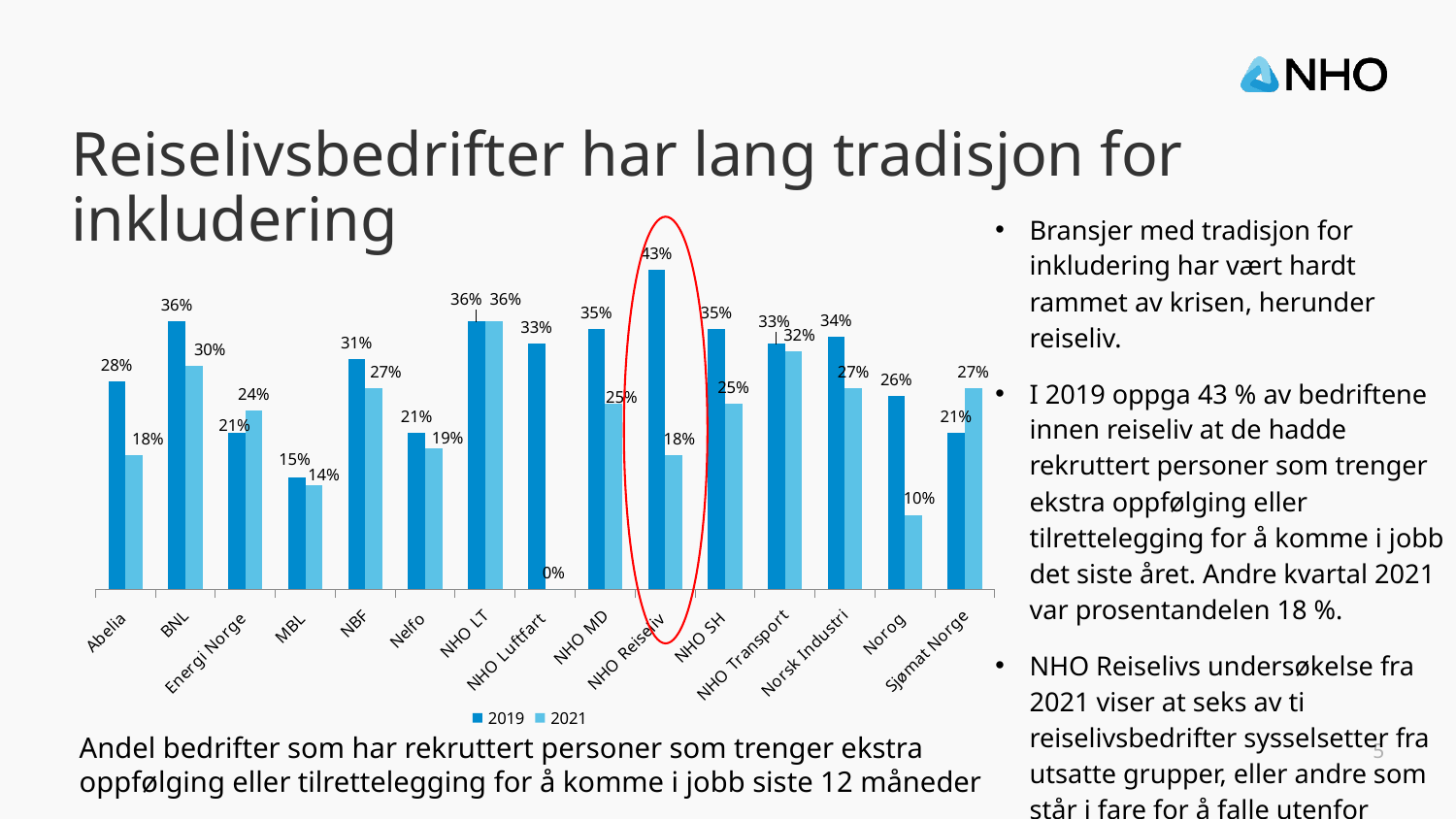
What is the 2019 value for NHO Reiseliv? 43% How many series does the legend list? 2 What is the difference between the 2019 and 2021 values for NHO Reiseliv? 25 percentage points What is the 2021 value for Norog? 10% What kind of chart is shown on the slide? Bar chart Which category has the lowest 2019 value? MBL Which category has the highest 2019 value? NHO Reiseliv Which category is circled in red on the chart? NHO Reiseliv Which is larger for Sjømat Norge, the 2019 value or the 2021 value? 2021 What is the 2021 value for NHO Luftfart? 0% How many categories are shown on the x axis? 15 Which category has the highest 2021 value? NHO LT